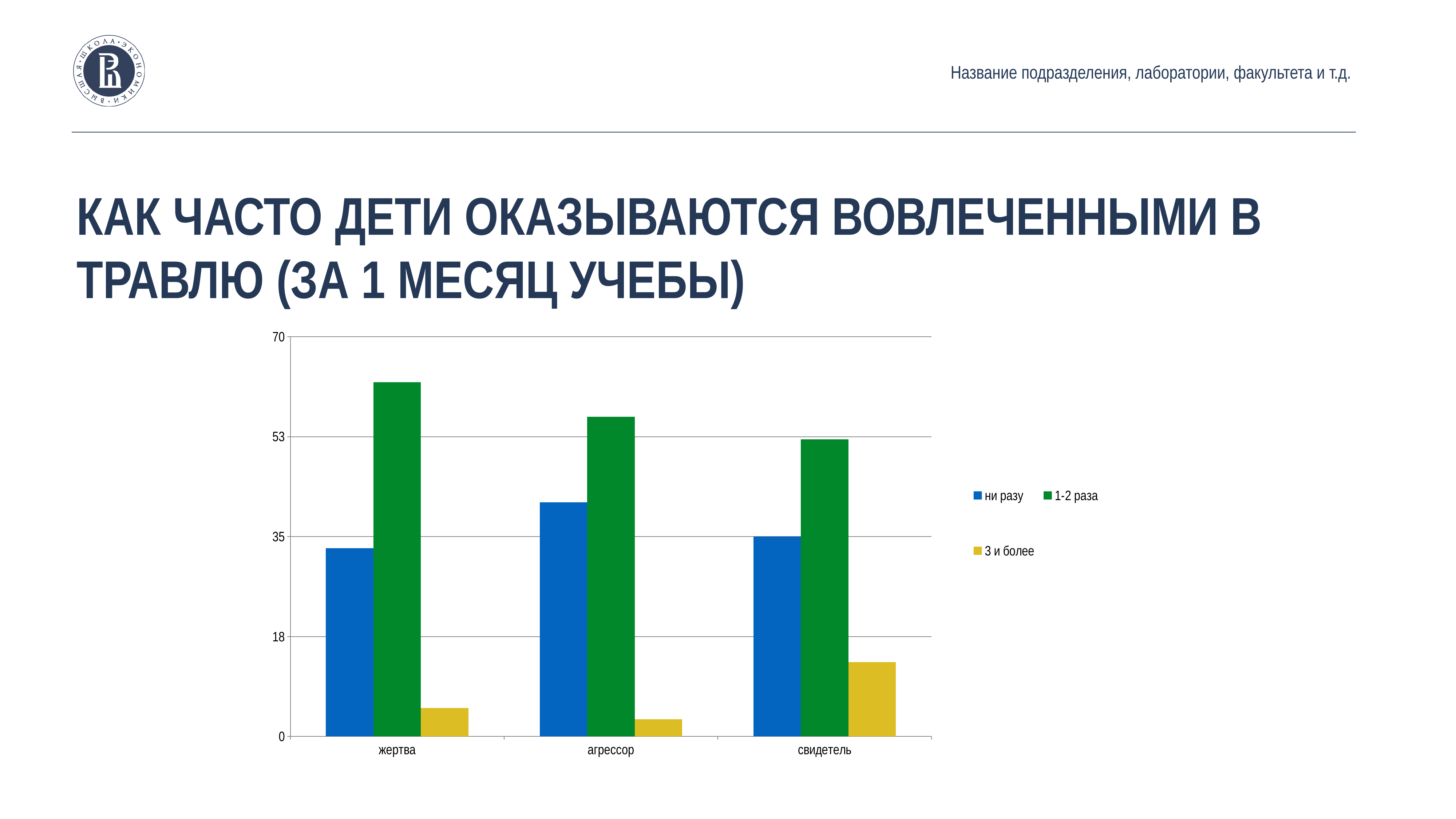
Is the value for "1-2 раза" in the category "жертва" greater or less than 53? greater Which category has the lowest value for the series "3 и более"? агрессор How many series does the chart's legend list? 3 How many categories are shown on the x axis of the chart? 3 For the series "1-2 раза", which is larger: the value for "жертва" or the value for "агрессор"? жертва What kind of chart is shown on the slide? bar chart What colour are the bars for the series "3 и более"? yellow Which category has the highest value for the series "1-2 раза"? жертва Which category has the highest value for the series "ни разу"? агрессор Is the value for "ни разу" in the category "агрессор" greater or less than 35? greater Is the value for "3 и более" in the category "свидетель" greater or less than 18? less Which category has the highest value for the series "3 и более"? свидетель